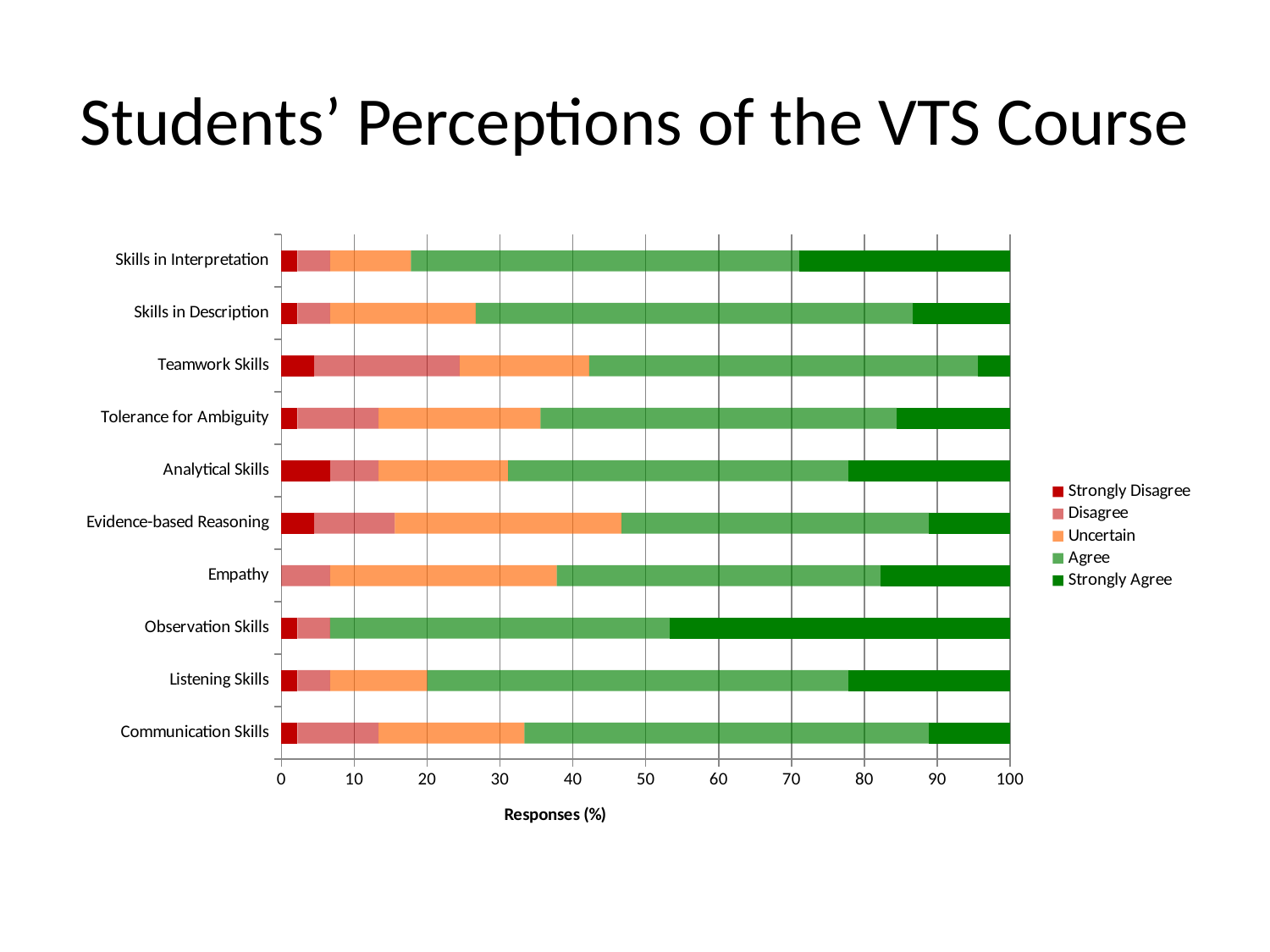
What kind of chart is shown on the slide? Stacked bar chart What is the total of the stacked bar for Communication Skills? 100 How many series does the legend list? 5 Which category has the largest Strongly Agree segment? Observation Skills Which category has the largest Disagree segment? Teamwork Skills Is the Strongly Agree share for Observation Skills greater or less than 40? greater How many skill categories are plotted on the chart? 10 Is the Uncertain share for Evidence-based Reasoning greater or less than 20? greater What is the label on the horizontal axis? Responses (%) Which has the larger Strongly Agree segment, Skills in Interpretation or Skills in Description? Skills in Interpretation Is the Strongly Agree share for Teamwork Skills greater or less than 10? less Which category has the smallest Strongly Agree segment? Teamwork Skills